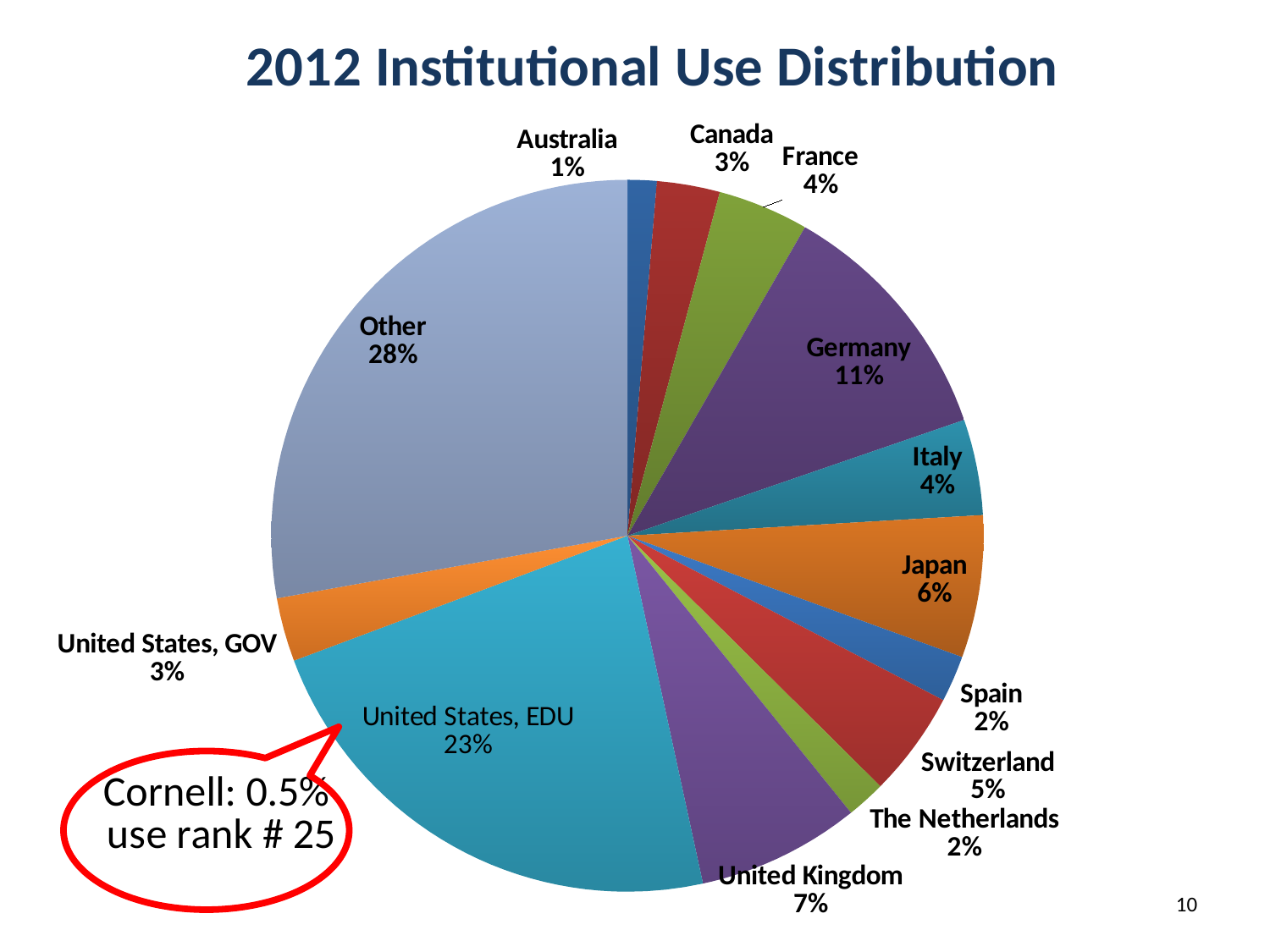
How many slices does the pie chart have? 13 What type of chart is shown on the slide? Pie chart What is the combined share of United States, EDU and United States, GOV? 26% Which is larger, the share for Switzerland or the share for Italy? Switzerland What percentage is shown for United States, EDU? 23% What share of the pie does Germany hold? 11% Which slice of the pie is the largest? Other What is the difference in percentage points between Germany and Japan? 5 What percentage is shown for Cornell in the callout on the slide? 0.5% What percentage is shown for the United Kingdom? 7% What is the title of the chart? 2012 Institutional Use Distribution Which slice of the pie is the smallest? Australia